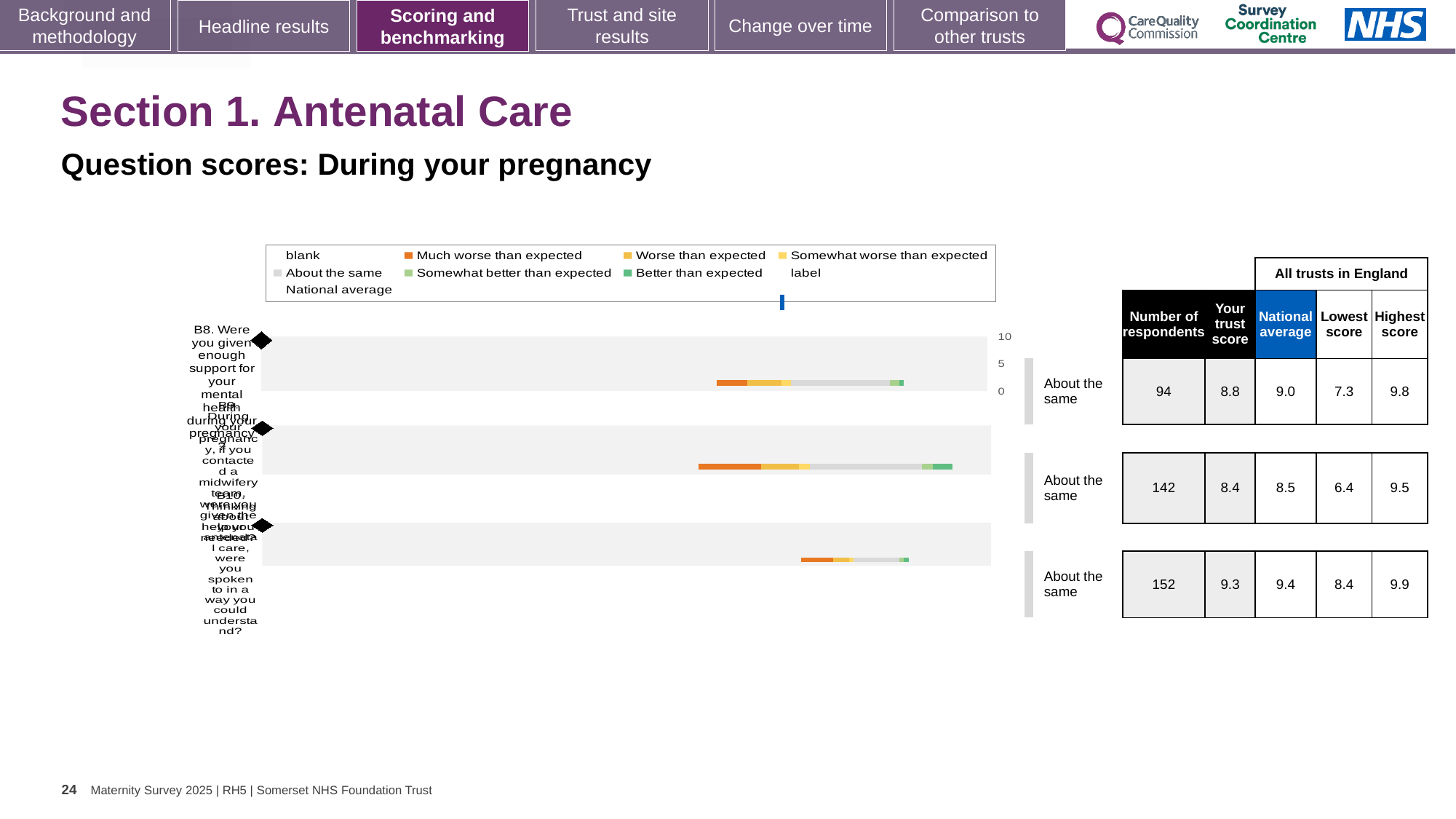
What kind of chart is used to show the question scores on this slide? bar chart What benchmark category is shown for all three rows? About the same What is the national average for the row with 142 respondents? 8.5 Which row has the largest number of respondents? the third (bottom) row, with 152 What is the lowest score in England for the second row? 6.4 For the first row (B8), is the trust score higher or lower than the national average? lower What is the highest score in England for the third (bottom) row? 9.9 What is the 'Your trust score' for the first row (B8, support for your mental health during pregnancy)? 8.8 What is the difference between the highest and lowest scores for the third (bottom) row? 1.5 How many questions (rows) are plotted in the chart? 3 What colour represents 'Much worse than expected' in the legend? orange What is the difference between the national average and the trust score for the first row (B8)? 0.2